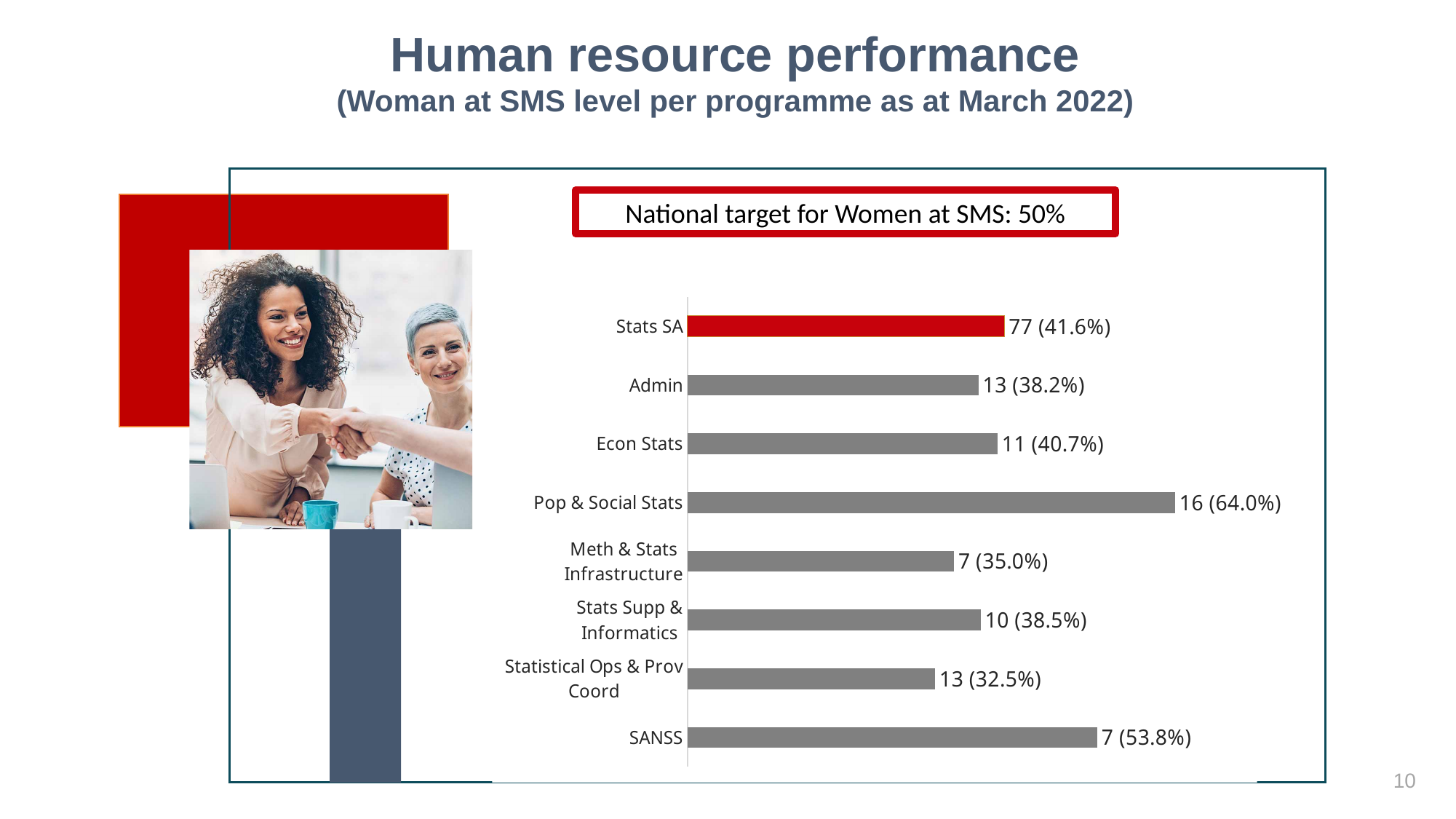
What is the difference in the number of women at SMS level between Admin and Econ Stats? 2 What is the data label shown for Stats SA? 77 (41.6%) Which has a higher percentage of women at SMS level, Meth & Stats Infrastructure or Admin? Admin How many women at SMS level are shown for Stats Supp & Informatics? 10 By how many percentage points does Pop & Social Stats exceed SANSS? 10.2 How many programmes (categories) are shown in the chart? 8 What is the national target for women at SMS level stated on the slide? 50% What percentage of women at SMS level is shown for Pop & Social Stats? 64.0% What percentage is shown for Statistical Ops & Prov Coord? 32.5% Which programme has the lowest percentage of women at SMS level? Statistical Ops & Prov Coord What type of chart is shown on the slide? Bar chart Which programme has the highest percentage of women at SMS level? Pop & Social Stats